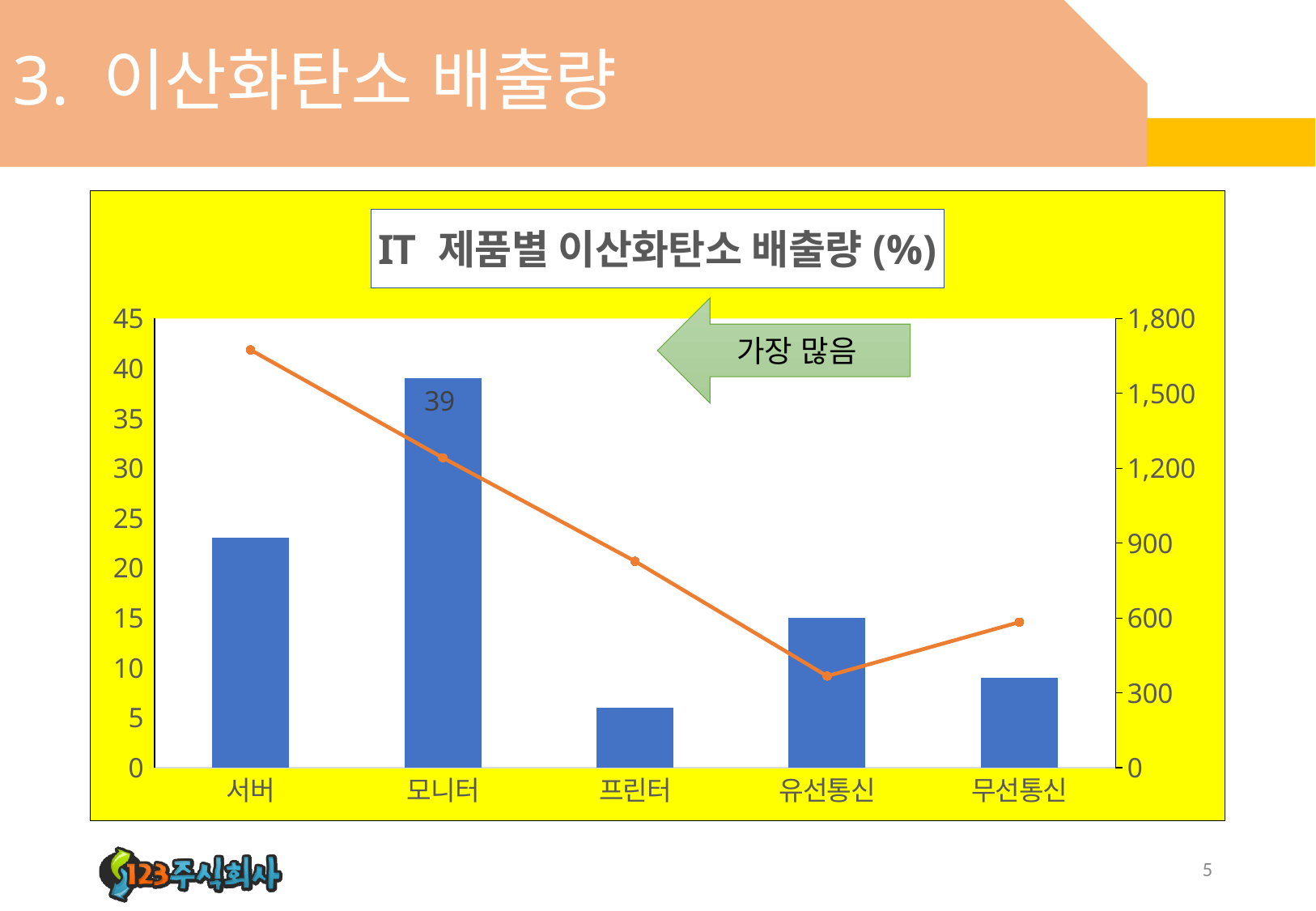
Which bar is taller, 서버 or 유선통신? 서버 What is the value of the bar for 모니터? 39 Is the bar value for 서버 greater or less than 20? greater At which category does the orange line reach its lowest point? 유선통신 Which category has the tallest bar? 모니터 How many categories are shown on the x axis? 5 Which category has the shortest bar? 프린터 Is the bar value for 프린터 greater or less than 10? less What kind of chart is shown on the slide? Combination bar and line chart At which category does the orange line reach its highest point? 서버 What is the title of the chart? IT 제품별 이산화탄소 배출량 (%) Is the orange line value for 프린터 greater or less than 900 on the right axis? less